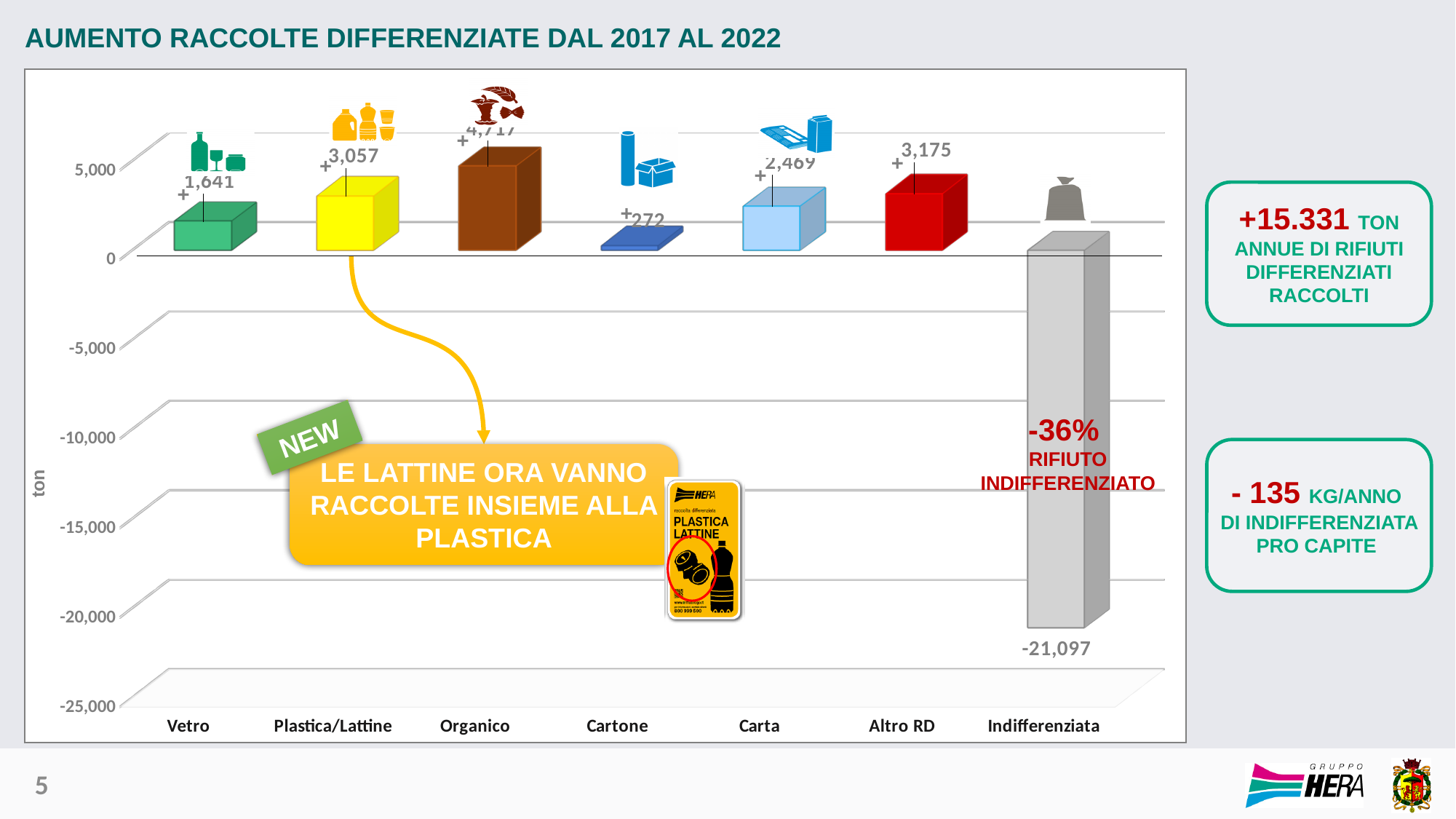
What is the value shown for Cartone? +272 Which category has the highest value in the chart? Organico What is the value shown for Altro RD? +3,175 How many categories are shown on the x axis of the chart? 7 What is the difference between the values for Altro RD and Plastica/Lattine? 118 What is the value shown for Plastica/Lattine? +3,057 What is the value shown for Indifferenziata? -21,097 What is the value shown for Vetro? +1,641 What is the value shown for Carta? +2,469 Which is larger, the value for Carta or the value for Altro RD? Altro RD What unit is shown on the y axis of the chart? ton Which category has the lowest value in the chart? Indifferenziata